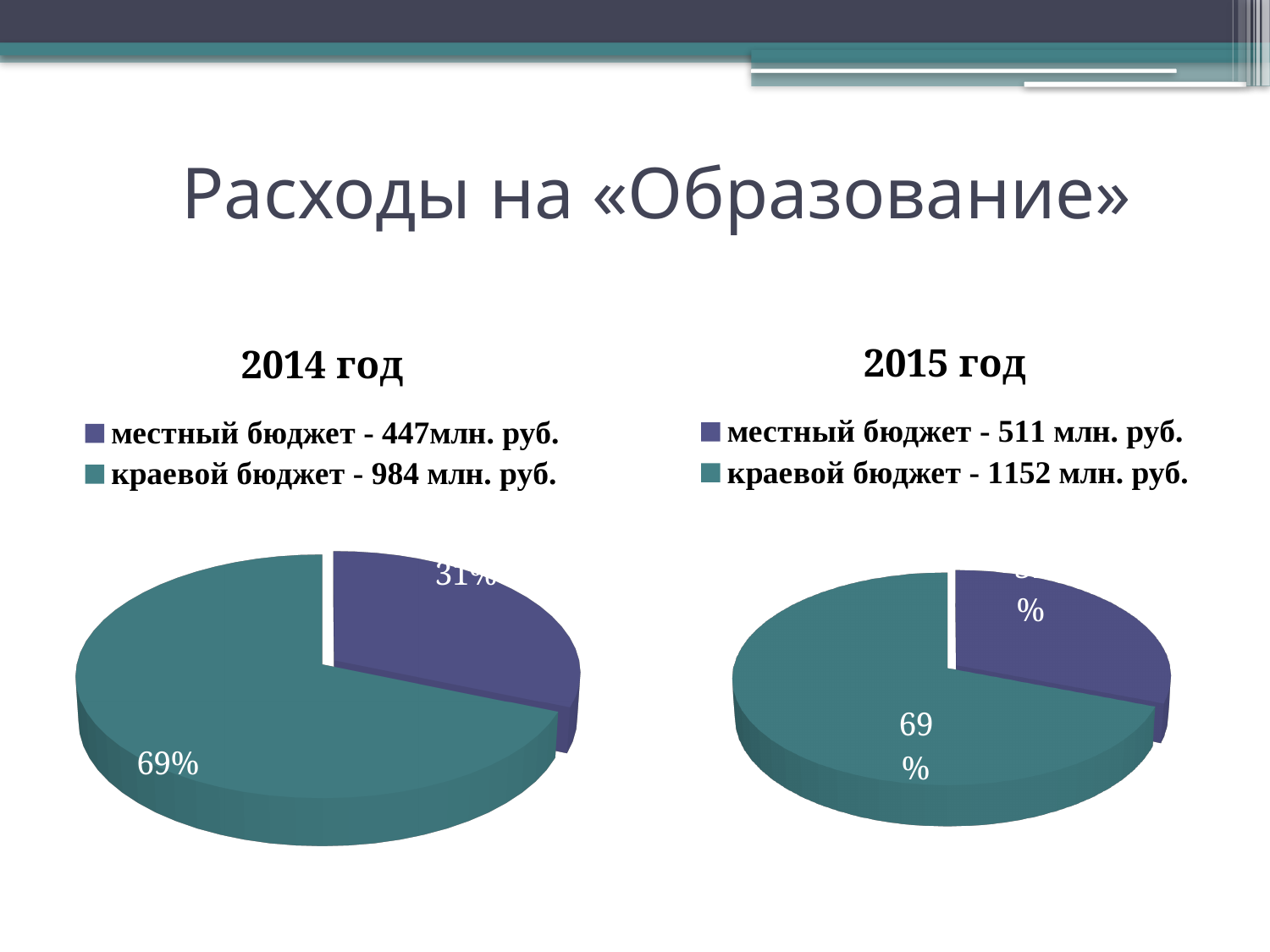
Using the legend values of the "2015 год" chart, what is the difference between краевой бюджет and местный бюджет? 641 млн. руб. How many slices does the "2015 год" pie chart have? 2 In the "2014 год" chart, which category is the smallest? местный бюджет According to the legend of the "2015 год" chart, what is the value for краевой бюджет? 1152 млн. руб. In the "2014 год" chart, what share of the pie does местный бюджет take? 31% In the "2014 год" chart, what share of the pie does краевой бюджет take? 69% What is the title of the slide containing the two pie charts? Расходы на «Образование» In the "2015 год" chart, what share of the pie does краевой бюджет take? 69% Using the legend values of the "2014 год" chart, what is the total of местный бюджет and краевой бюджет? 1431 млн. руб. What kind of chart is the "2014 год" chart? pie chart In the "2015 год" chart, which category is the largest? краевой бюджет According to the legend of the "2014 год" chart, what is the value for местный бюджет? 447млн. руб.